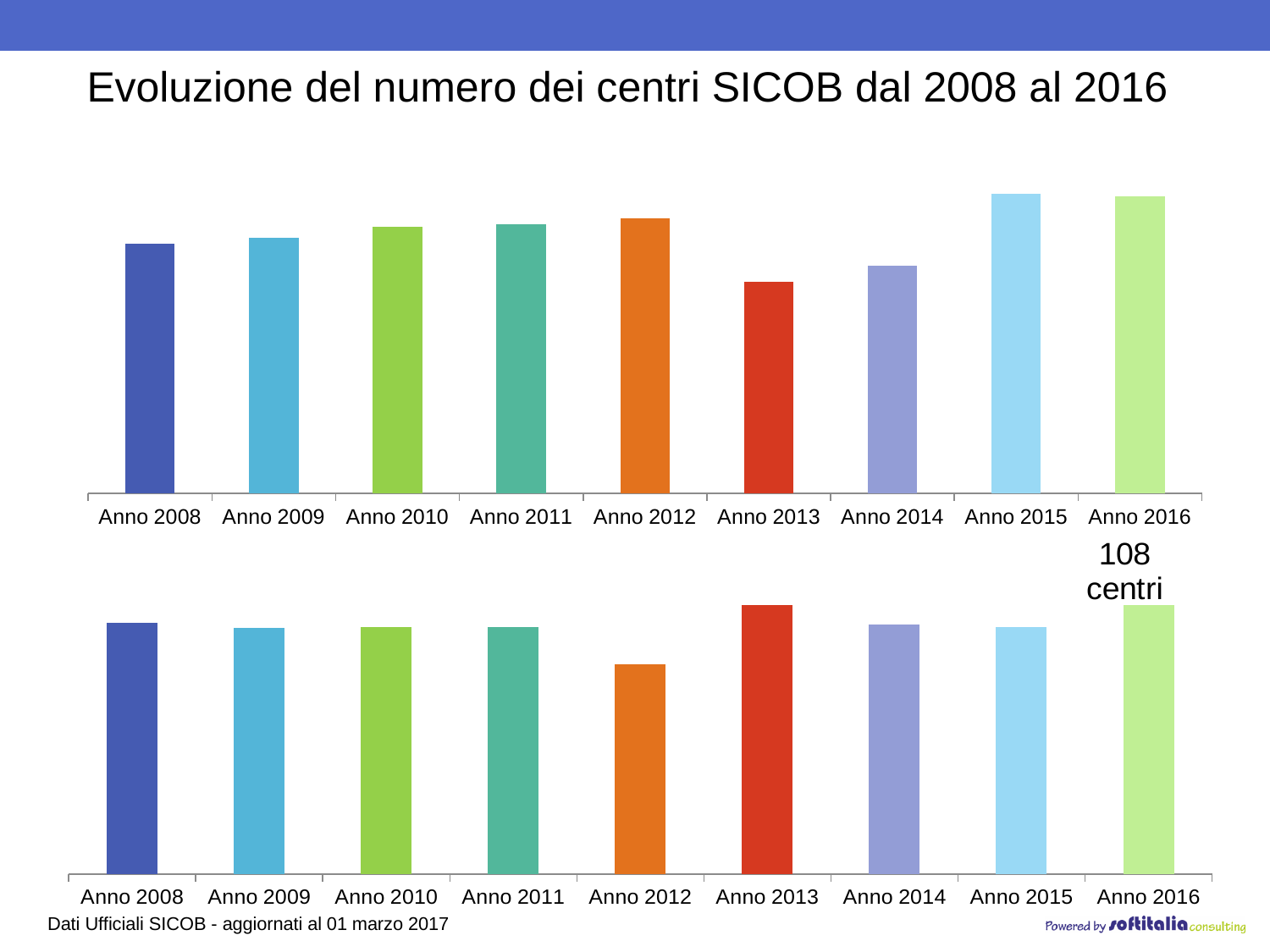
On the top chart, which is larger, the bar for Anno 2012 or the bar for Anno 2013? Anno 2012 What kind of chart is the top chart on the slide? bar chart How many categories (years) does the top chart show? 9 On the top chart, do the bars rise or fall from Anno 2008 to Anno 2012? rise What is the title of the slide's chart? Evoluzione del numero dei centri SICOB dal 2008 al 2016 How many categories (years) does the bottom chart show? 9 What text is printed above the Anno 2016 bar of the bottom chart? 108 centri On the bottom chart, which is larger, the bar for Anno 2013 or the bar for Anno 2008? Anno 2013 On the top chart, which year has the lowest bar? Anno 2013 On the bottom chart, which year has the lowest bar? Anno 2012 On the bottom chart, which is larger, the bar for Anno 2012 or the bar for Anno 2014? Anno 2014